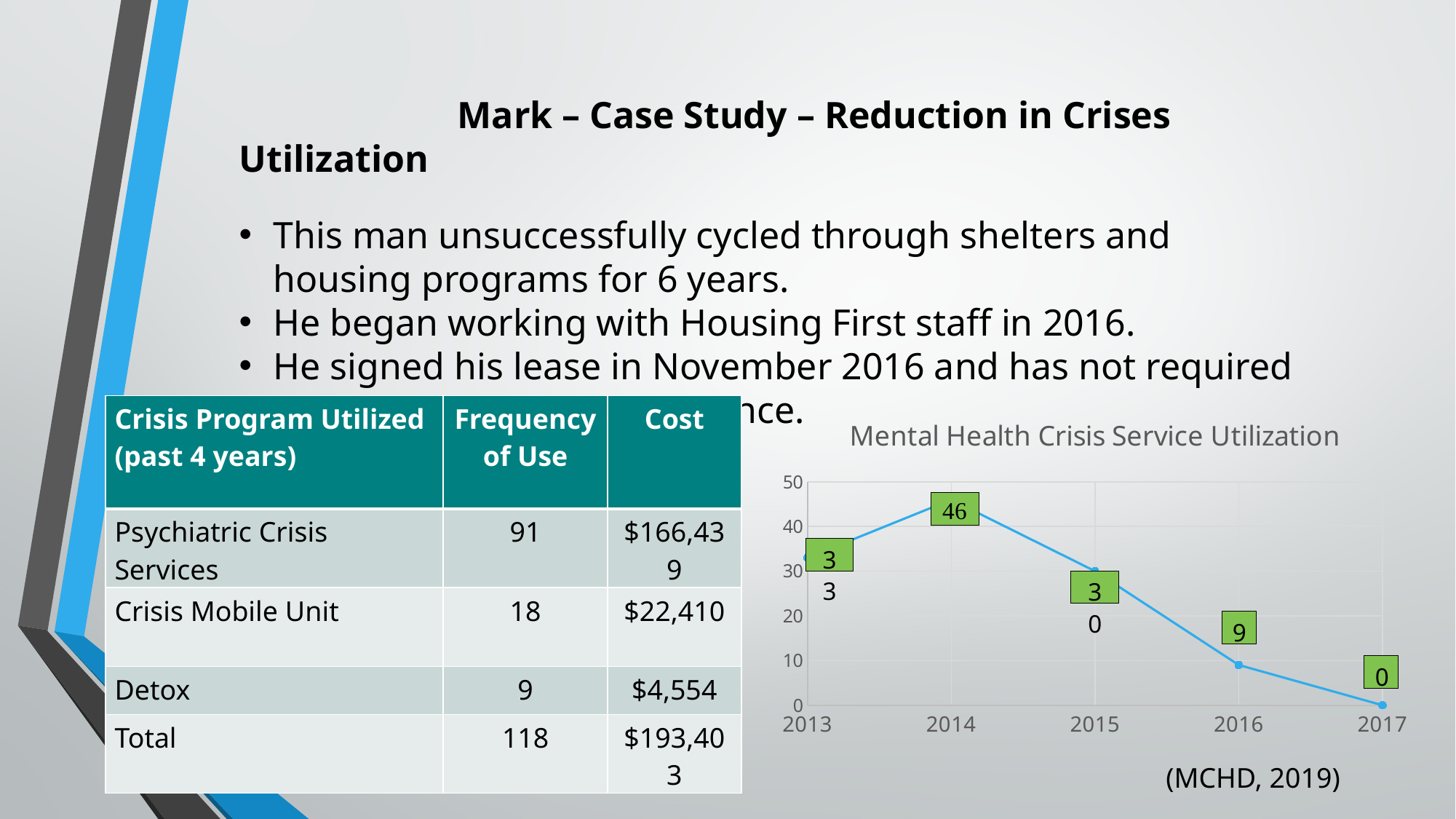
Which year has the highest value in the chart? 2014 What is the value for 2014 in the Mental Health Crisis Service Utilization chart? 46 Is the value for 2013 greater or less than 20? greater What is the title of the chart? Mental Health Crisis Service Utilization What type of chart is shown on the slide? line chart Is the value for 2015 greater or less than 40? less Which year has the lowest value in the chart? 2017 What is the difference between the values for 2014 and 2016? 37 Do the values rise or fall from 2014 to 2017? fall How many years are plotted on the x axis of the chart? 5 What is the value for 2017 in the Mental Health Crisis Service Utilization chart? 0 What is the value for 2016 in the Mental Health Crisis Service Utilization chart? 9